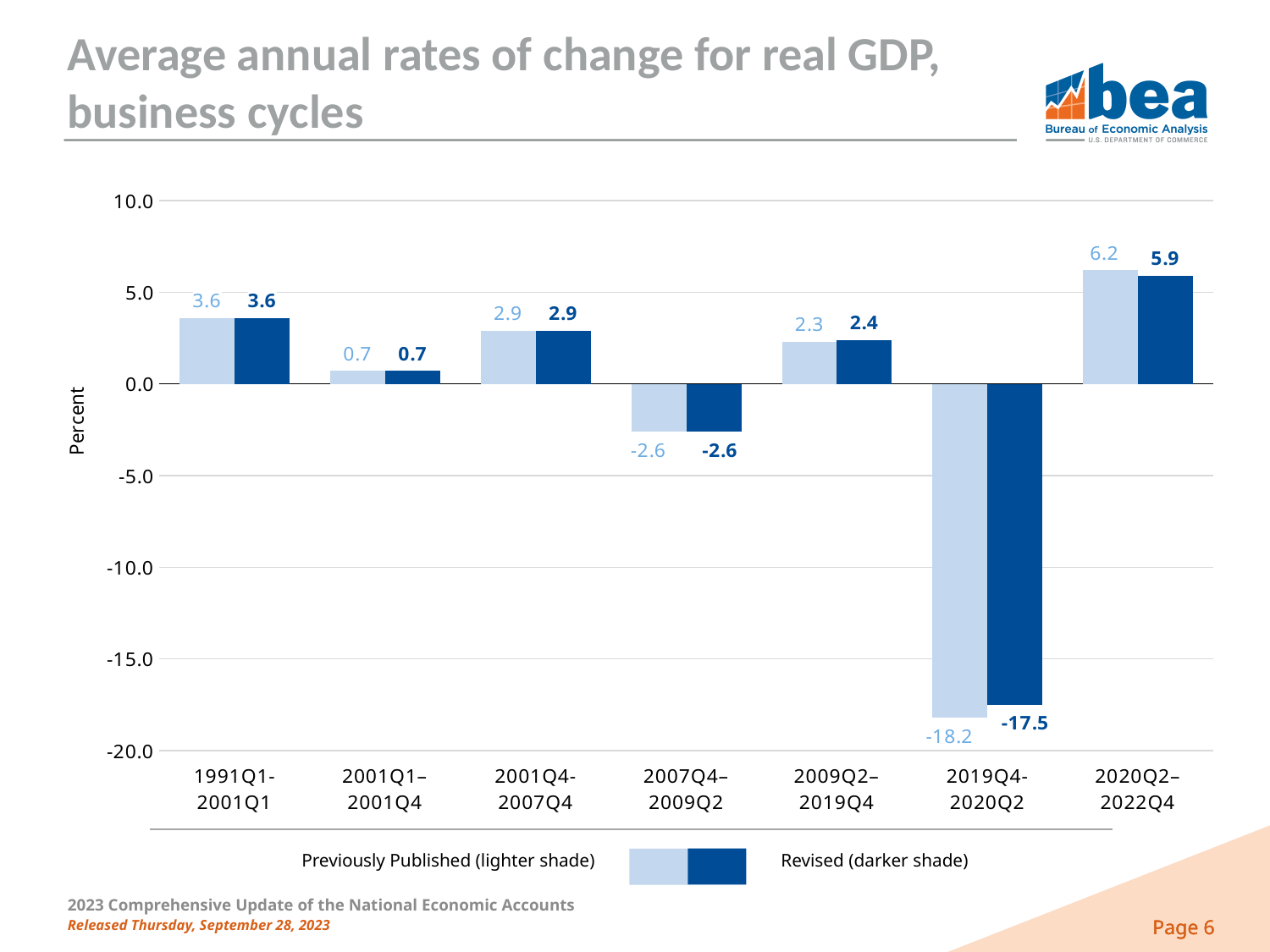
Which is larger for 2020Q2–2022Q4, the Previously Published value or the Revised value? Previously Published Which business cycle has the lowest Revised value? 2019Q4-2020Q2 What is the difference between the Previously Published and Revised values for 2019Q4-2020Q2? 0.7 What is the label of the y axis? Percent What is the difference between the Previously Published and Revised values for 2009Q2–2019Q4? 0.1 How many series does the legend list? 2 How many business cycles are shown on the x axis? 7 What is the Revised value for 2020Q2–2022Q4? 5.9 What is the Revised value for 2009Q2–2019Q4? 2.4 Which business cycle has the highest Previously Published value? 2020Q2–2022Q4 What is the Previously Published value for 2019Q4-2020Q2? -18.2 What kind of chart is shown on the slide? Bar chart